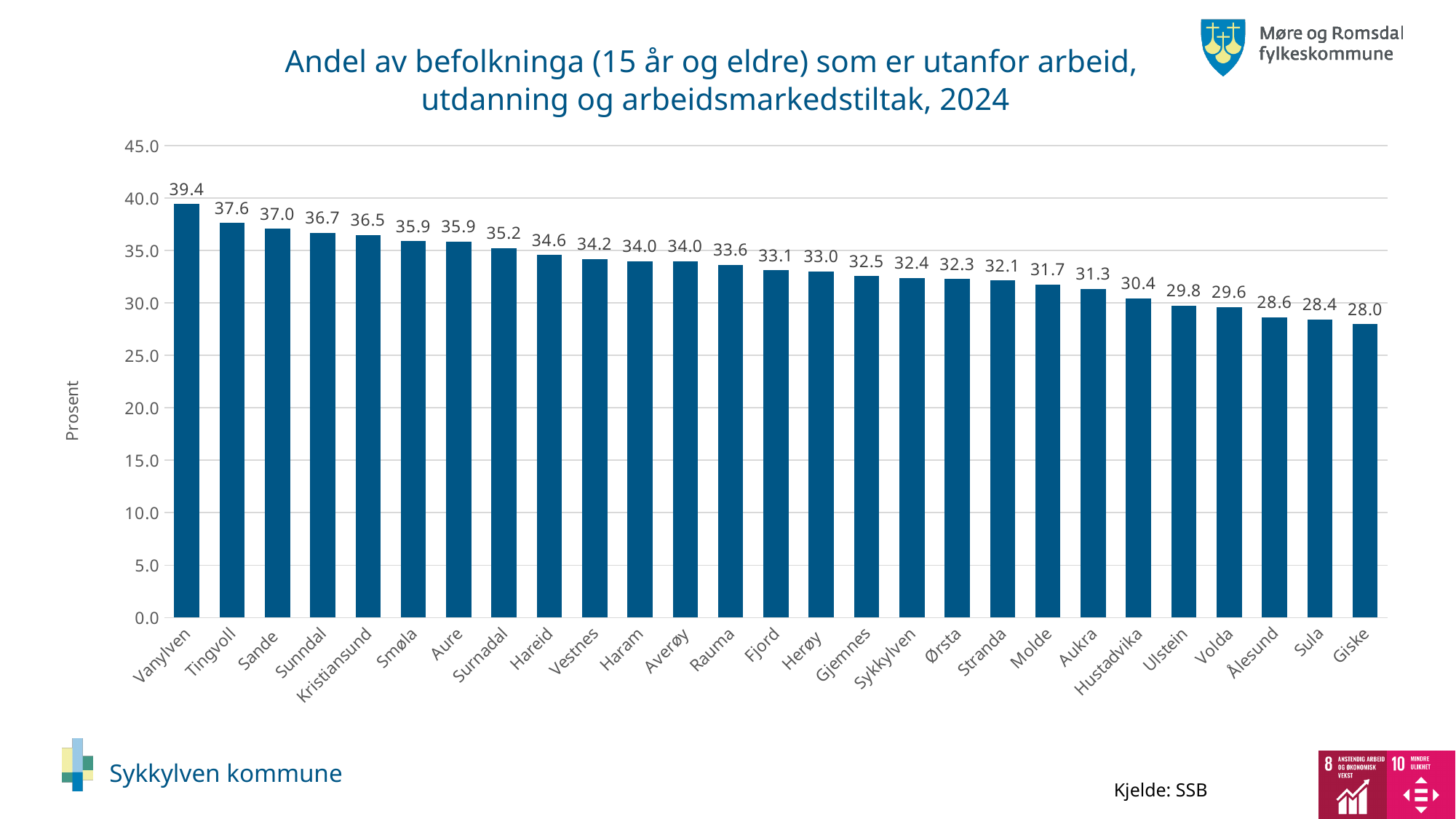
What is the difference between the values for Vanylven and Giske? 11.4 What is the difference between the values for Tingvoll and Sykkylven? 5.2 How many municipalities are shown on the x axis? 27 What kind of chart is shown on the slide? bar chart Is the value for Hustadvika greater or less than 35.0? less Which municipality has the highest value? Vanylven What is the label of the y axis? Prosent Which municipality has the lowest value? Giske What is the value for Sykkylven? 32.4 What is the value for Molde? 31.7 Which is larger, the value for Ålesund or the value for Ørsta? Ørsta What is the value for Kristiansund? 36.5